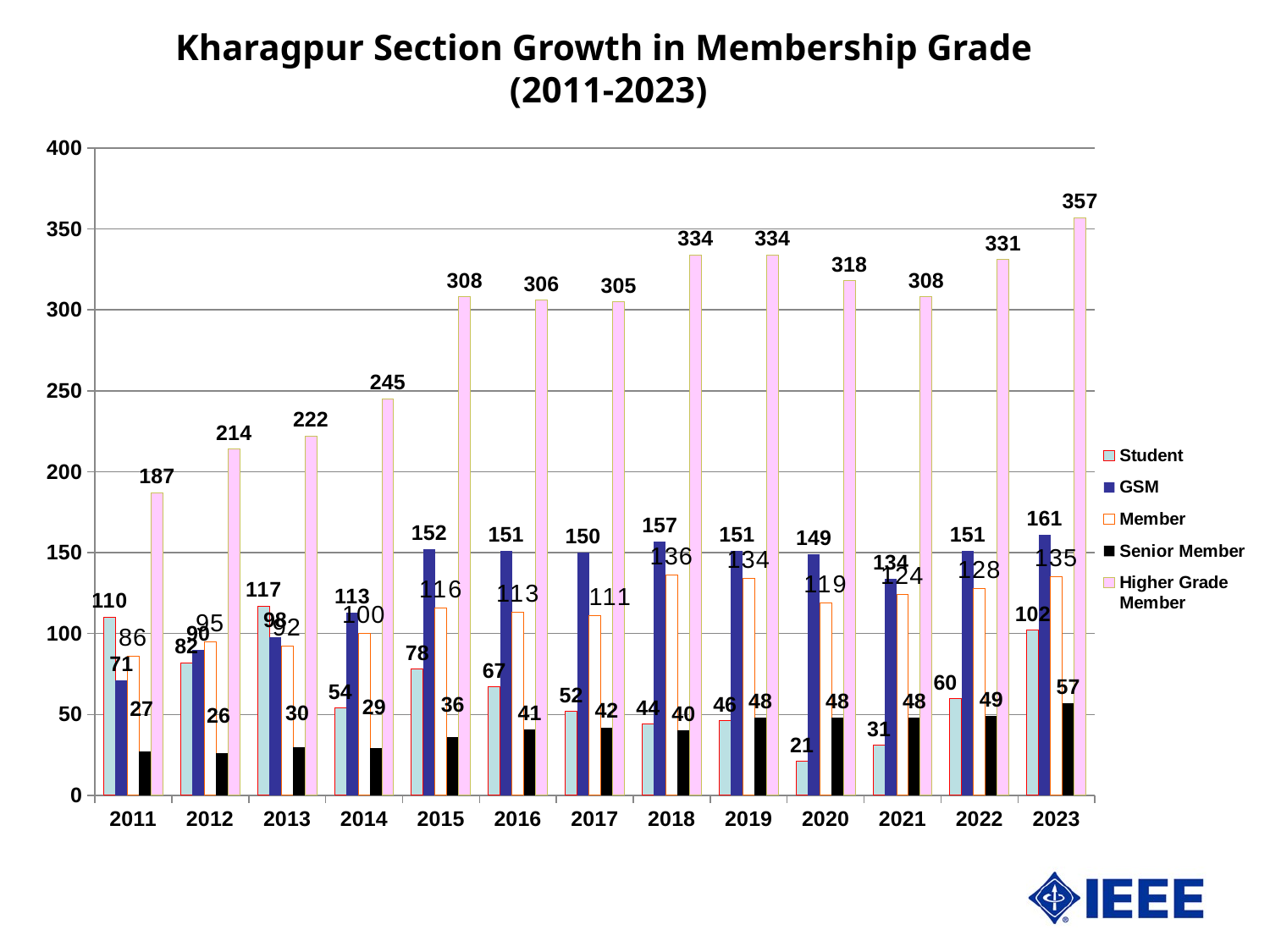
What is the value for Senior Member in 2023? 57 In 2023, which is larger: GSM or Member? GSM In which year is the Senior Member value highest? 2023 What kind of chart is shown on the slide? Bar chart Does the Higher Grade Member value generally rise or fall from 2011 to 2023? Rise In which year is the Student value lowest? 2020 What is the value for Higher Grade Member in 2023? 357 How many series does the legend list? 5 How many years are shown on the x axis? 13 What is the difference between the Higher Grade Member values in 2023 and 2011? 170 In which year is the Higher Grade Member value highest? 2023 What is the value for Student in 2020? 21